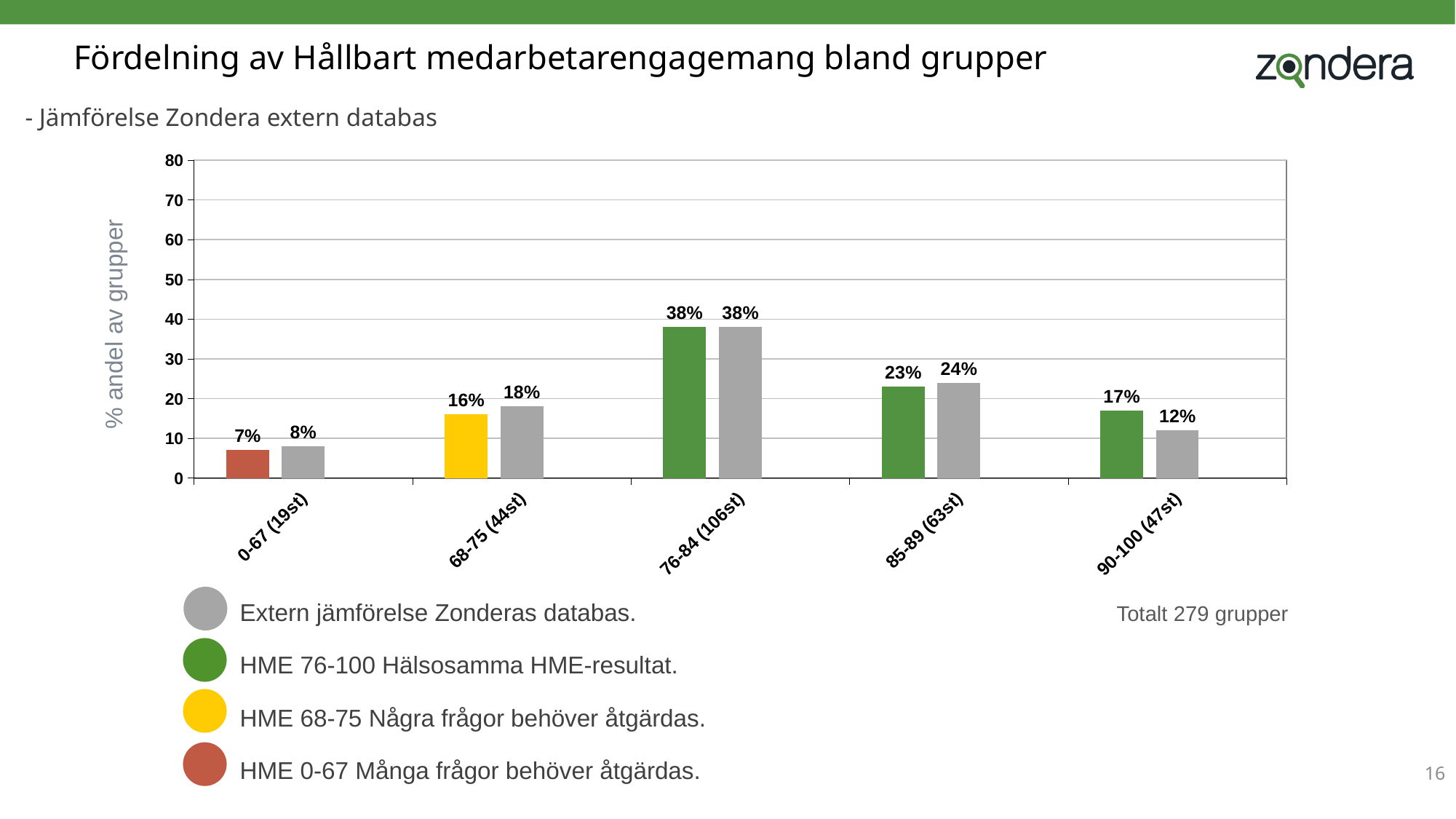
What kind of chart is shown on the slide? bar chart What is the label of the y axis? % andel av grupper What is the value of the coloured (non-grey) bar for the 90-100 (47st) category? 17% In the 68-75 (44st) category, which is larger: the yellow bar or the grey bar? the grey bar What is the difference between the coloured bar and the grey bar in the 90-100 (47st) category? 5% What is the value of the grey external comparison bar for the 68-75 (44st) category? 18% What is the value of the red bar for the 0-67 (19st) category? 7% Which category has the highest value among the coloured (non-grey) bars? 76-84 (106st) What is the value of the grey external comparison bar for the 76-84 (106st) category? 38% Which category has the lowest value among the grey external comparison bars? 0-67 (19st) What total number of groups is stated below the chart? Totalt 279 grupper How many categories are shown on the x axis? 5